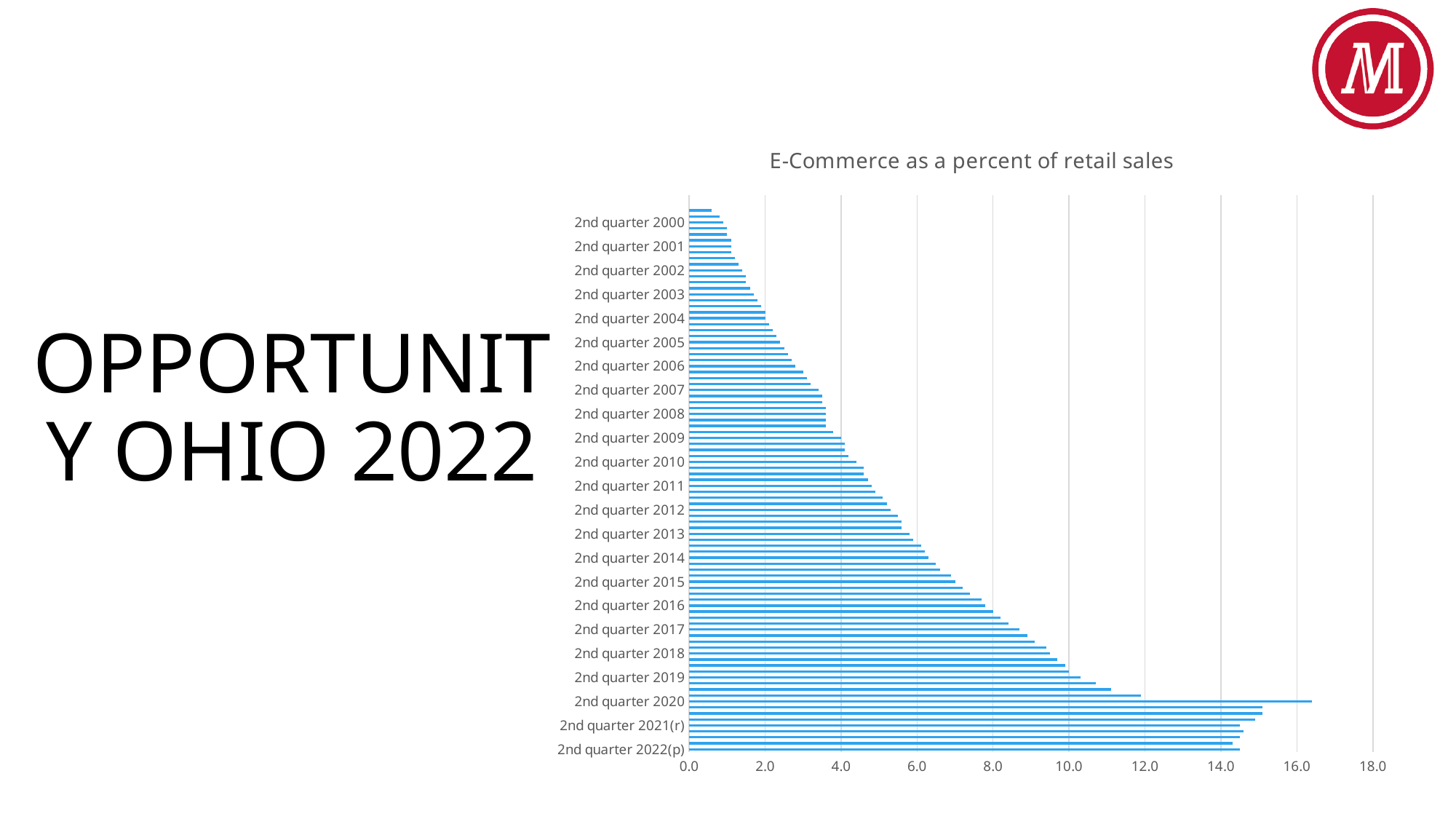
What kind of chart is shown on the slide? bar chart Which labeled category has the longest bar in the chart? 2nd quarter 2020 Is the value for 2nd quarter 2008 greater or less than 4.0? less Do the values generally rise or fall from 2nd quarter 2000 to 2nd quarter 2022(p)? rise What is the title of the chart? E-Commerce as a percent of retail sales Is the value for 2nd quarter 2015 greater or less than 6.0? greater Which labeled category has the shortest bar in the chart? 2nd quarter 2000 Is the value for 2nd quarter 2022(p) greater or less than 16.0? less Which is larger, the value for 2nd quarter 2010 or the value for 2nd quarter 2018? 2nd quarter 2018